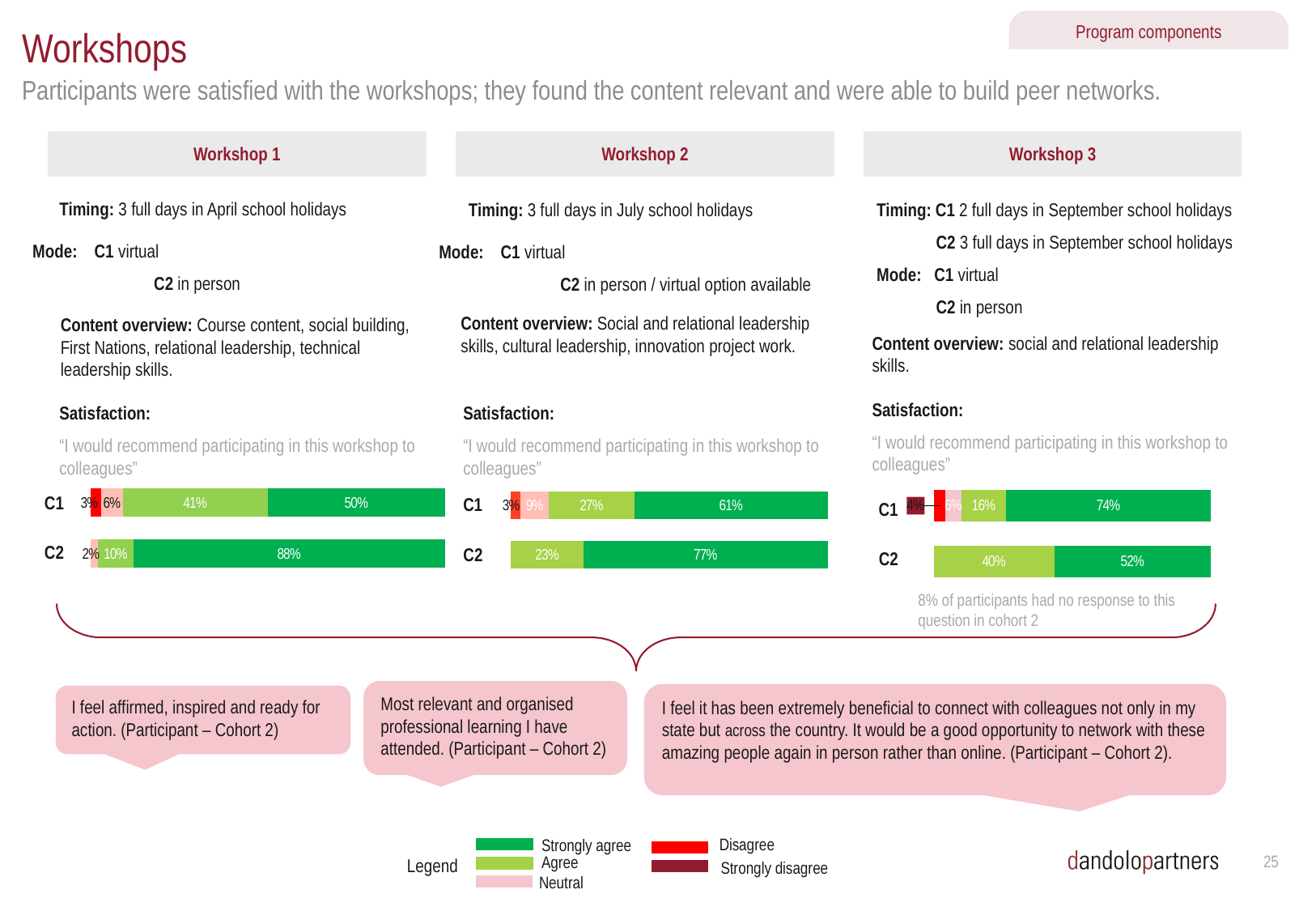
In the Workshop 3 chart, what is the difference between the 'Agree' shares of C2 and C1? 24% In the Workshop 1 chart, what percentage of C1 participants agreed (light green) that they would recommend the workshop? 41% In the Workshop 2 chart, what percentage of C1 participants strongly agreed? 61% How many response categories does the legend at the bottom of the slide list? 5 In the Workshop 3 chart, what percentage of C2 participants agreed (light green)? 40% In the Workshop 1 chart, which cohort has the larger 'Strongly agree' share, C1 or C2? C2 What type of chart is used to show satisfaction for each workshop? Stacked bar chart In the Workshop 2 chart, what is the difference between the 'Strongly agree' shares of C2 and C1? 16% In the Workshop 3 chart, what percentage of C1 participants strongly agreed? 74% In the Workshop 1 chart, what percentage of C2 participants strongly agreed that they would recommend the workshop? 88% In the Workshop 2 chart, what percentage of C2 participants agreed (light green)? 23%